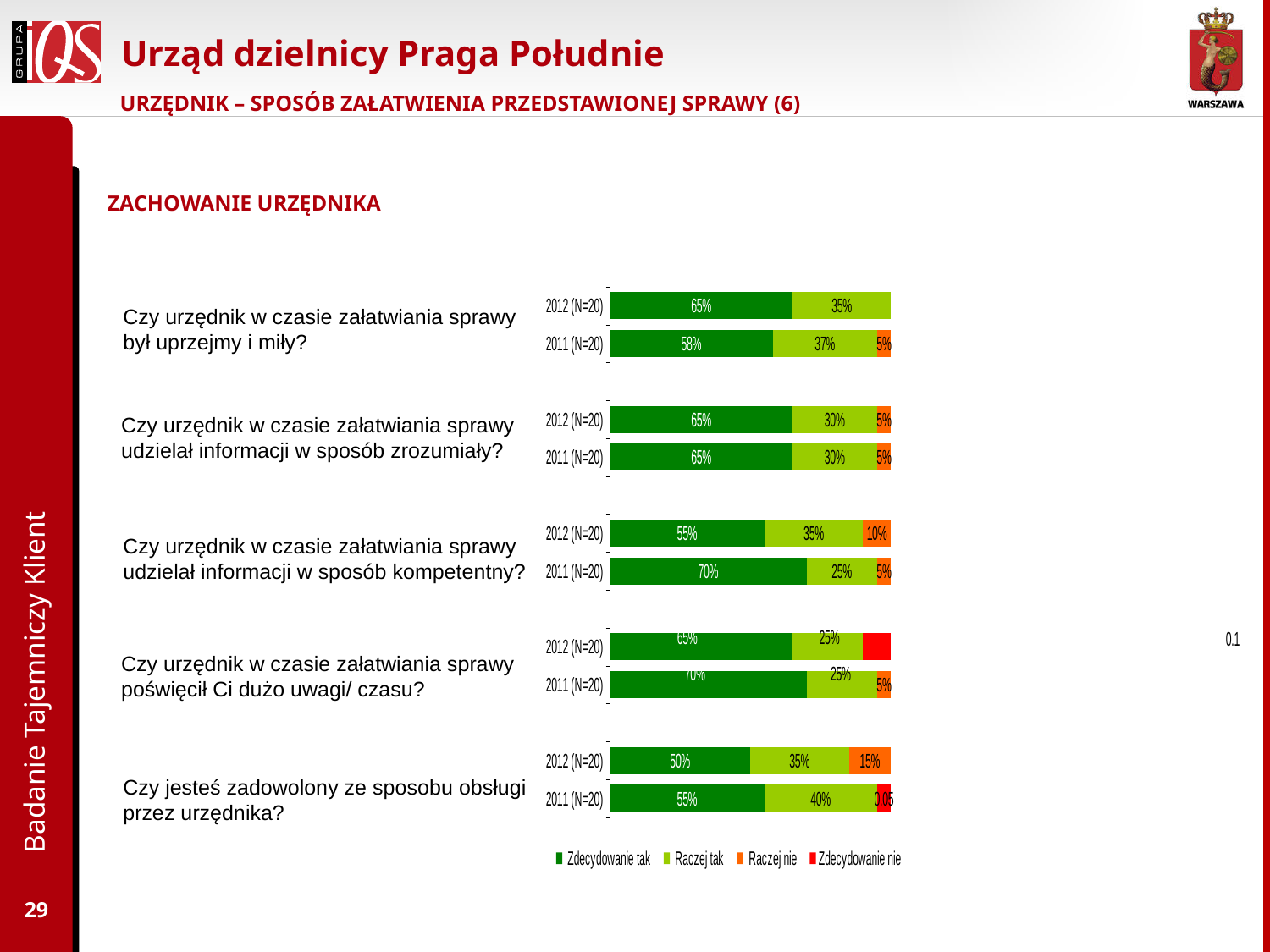
What is the 'Zdecydowanie tak' value for 2012 (N=20) for the question 'Czy urzędnik w czasie załatwiania sprawy był uprzejmy i miły?' 65% For the question 'Czy jesteś zadowolony ze sposobu obsługi przez urzędnika?', which year has the larger 'Zdecydowanie tak' value, 2012 (N=20) or 2011 (N=20)? 2011 (N=20) For the question 'Czy urzędnik w czasie załatwiania sprawy był uprzejmy i miły?', what is the difference between the 'Zdecydowanie tak' values for 2012 (N=20) and 2011 (N=20)? 7% What type of chart is shown on the slide? stacked bar chart How many series does the legend list? 4 What is the 'Raczej nie' value for 2012 (N=20) for the question 'Czy urzędnik w czasie załatwiania sprawy udzielał informacji w sposób kompetentny?' 10% What is the 'Zdecydowanie tak' value for 2011 (N=20) for the question 'Czy urzędnik w czasie załatwiania sprawy udzielał informacji w sposób kompetentny?' 70% What is the 'Raczej tak' value for 2011 (N=20) for the question 'Czy jesteś zadowolony ze sposobu obsługi przez urzędnika?' 40% What is the 'Raczej nie' value for 2012 (N=20) for the question 'Czy jesteś zadowolony ze sposobu obsługi przez urzędnika?' 15% What is the first entry in the chart legend? Zdecydowanie tak What is the 'Raczej tak' value for 2011 (N=20) for the question 'Czy urzędnik w czasie załatwiania sprawy był uprzejmy i miły?' 37% For the question 'Czy urzędnik w czasie załatwiania sprawy udzielał informacji w sposób kompetentny?', what is the difference between the 'Zdecydowanie tak' values for 2011 (N=20) and 2012 (N=20)? 15%